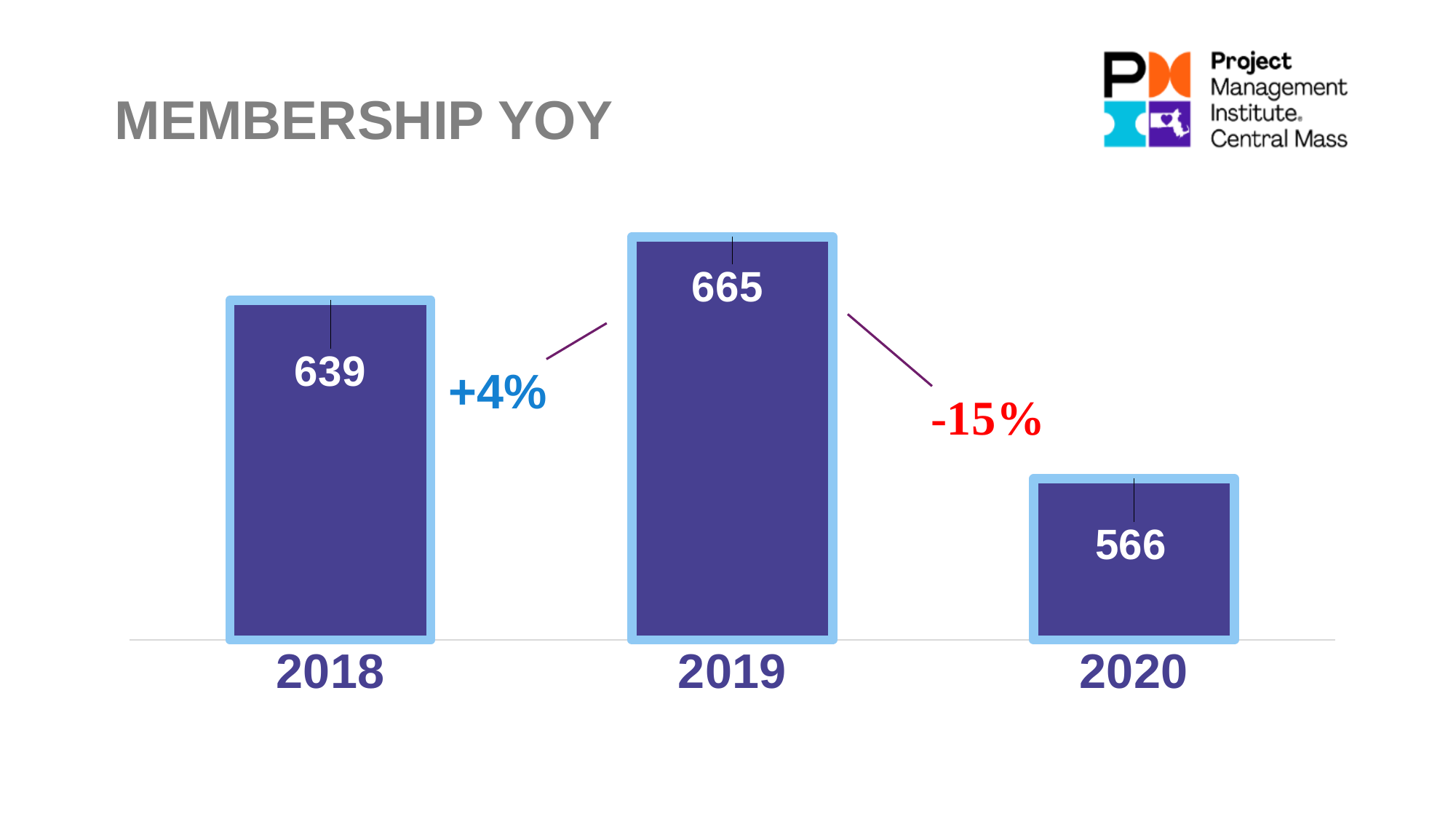
Which year has a larger membership, 2018 or 2020? 2018 What is the title of the chart? MEMBERSHIP YOY Which year has the highest membership? 2019 What kind of chart is shown on the slide? Bar chart What is the difference in membership between 2019 and 2018? 26 How many years are shown on the chart? 3 What is the membership value for 2019? 665 What is the difference in membership between 2019 and 2020? 99 What percentage change is shown between 2019 and 2020? -15% What is the membership value for 2020? 566 Which year has the lowest membership? 2020 What is the membership value for 2018? 639